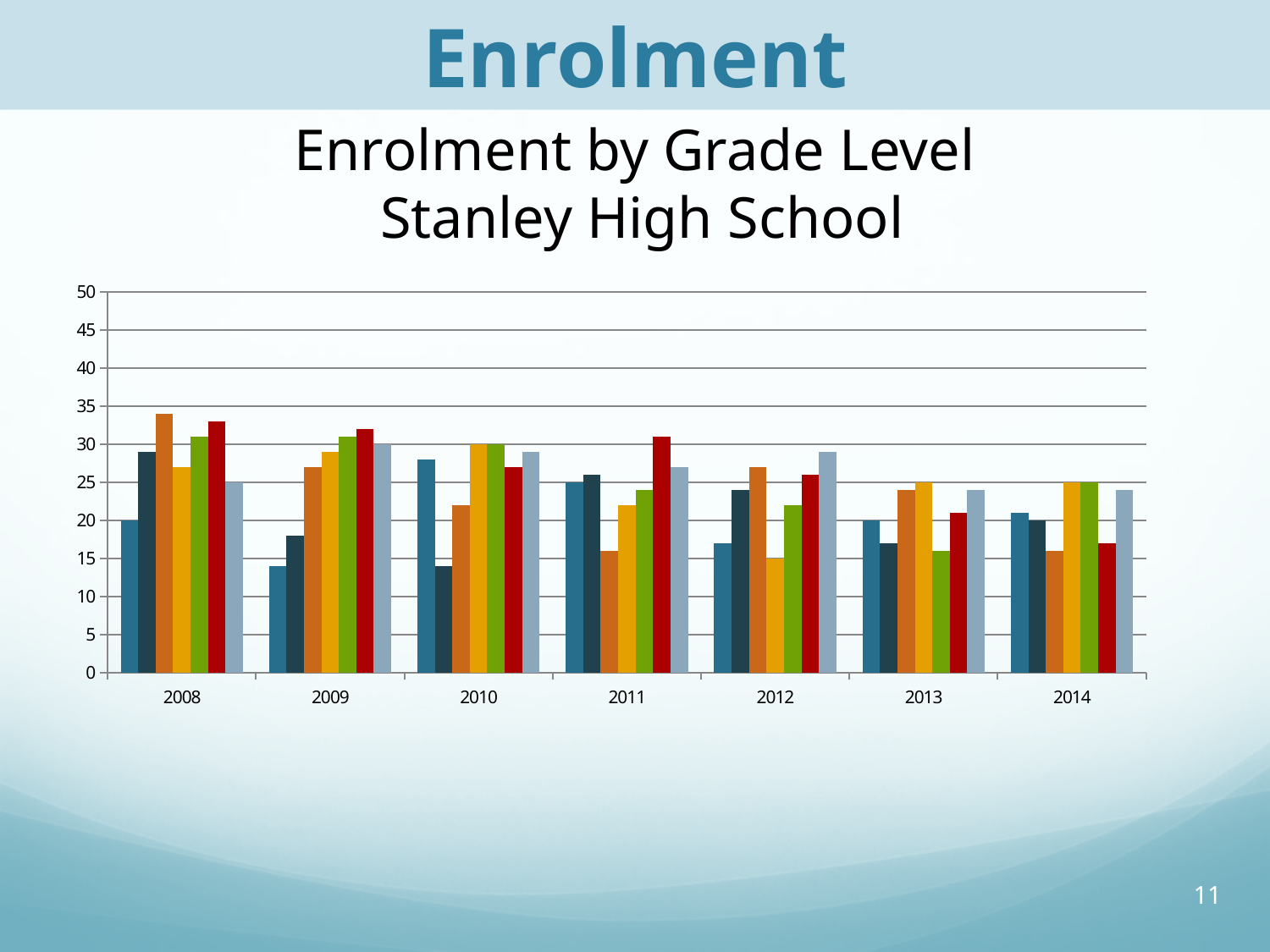
What is the value of the yellow bar for 2012? 15 Which bar is shortest in the 2012 group? the yellow bar What is the value of the last (light blue) bar for 2008? 25 What kind of chart is shown on the slide? bar chart What is the title of the chart? Enrolment by Grade Level Stanley High School How many bars are plotted for each year in the chart? 7 What is the difference between the last (light blue) bar and the first (blue) bar for 2008? 5 How many years are shown on the x axis of the chart? 7 Is the value of the green bar for 2013 greater or less than 20? less Which bar is tallest in the 2008 group? the orange bar What is the value of the first (blue) bar for 2008? 20 Is the value of the orange bar for 2008 greater or less than 30? greater